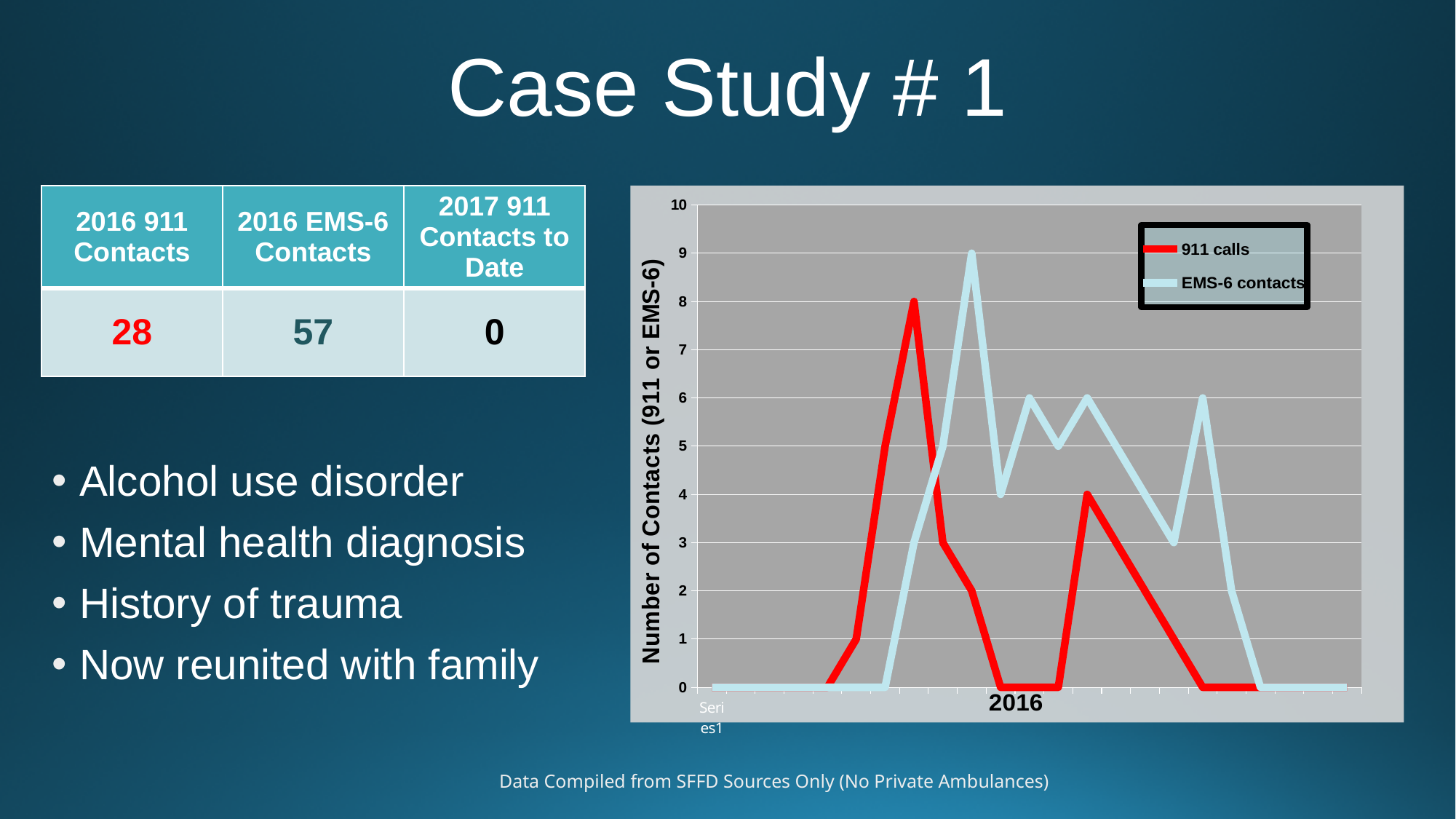
How many series does the chart's legend list? 2 What are the two series named in the chart's legend? 911 calls and EMS-6 contacts What is the title of the chart's vertical axis? Number of Contacts (911 or EMS-6) Which series reaches the higher peak value, 911 calls or EMS-6 contacts? EMS-6 contacts What is the highest value reached by the EMS-6 contacts line? 9 Is the peak value of the EMS-6 contacts line greater or less than 8? greater What is the highest value reached by the 911 calls line? 8 Is the peak value of the 911 calls line greater or less than 5? greater Which series has the single highest value on the chart? EMS-6 contacts What kind of chart is shown on the slide? line chart What is the difference between the peak value of EMS-6 contacts and the peak value of 911 calls? 1 Is the maximum value of the 911 calls line greater or less than 9? less